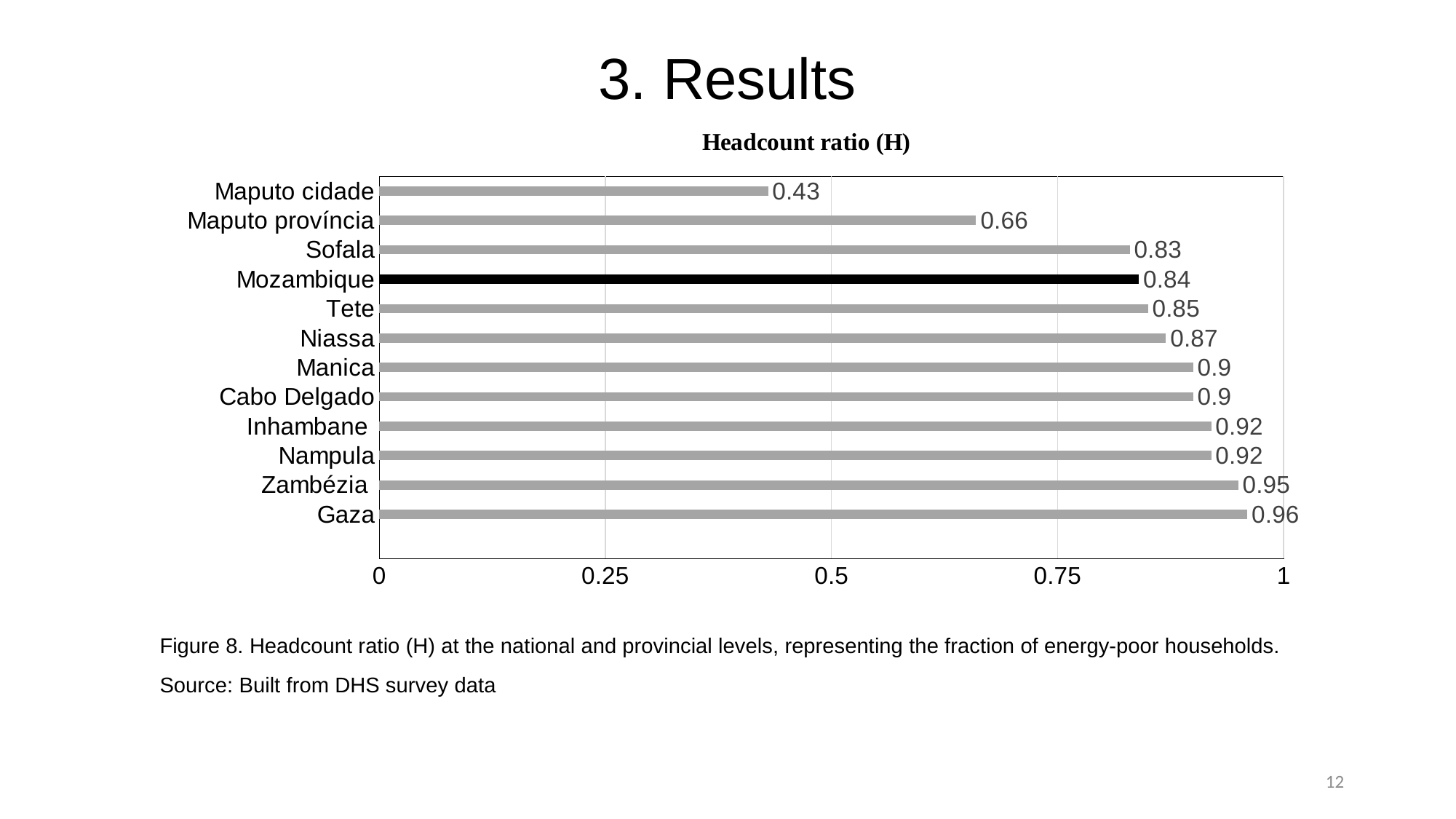
Which category has the lowest headcount ratio? Maputo cidade What is the headcount ratio for Zambézia? 0.95 What is the headcount ratio for Mozambique? 0.84 How many categories are shown in the chart? 12 What is the difference between the headcount ratio for Gaza and for Maputo cidade? 0.53 What is the headcount ratio for Maputo cidade? 0.43 Which has a higher headcount ratio, Tete or Niassa? Niassa What kind of chart is shown on the slide? bar chart Which bar is drawn in black rather than grey? Mozambique Is the headcount ratio for Maputo província greater or less than 0.75? less What is the difference between the headcount ratio for Maputo província and for Sofala? 0.17 Which category has the highest headcount ratio? Gaza